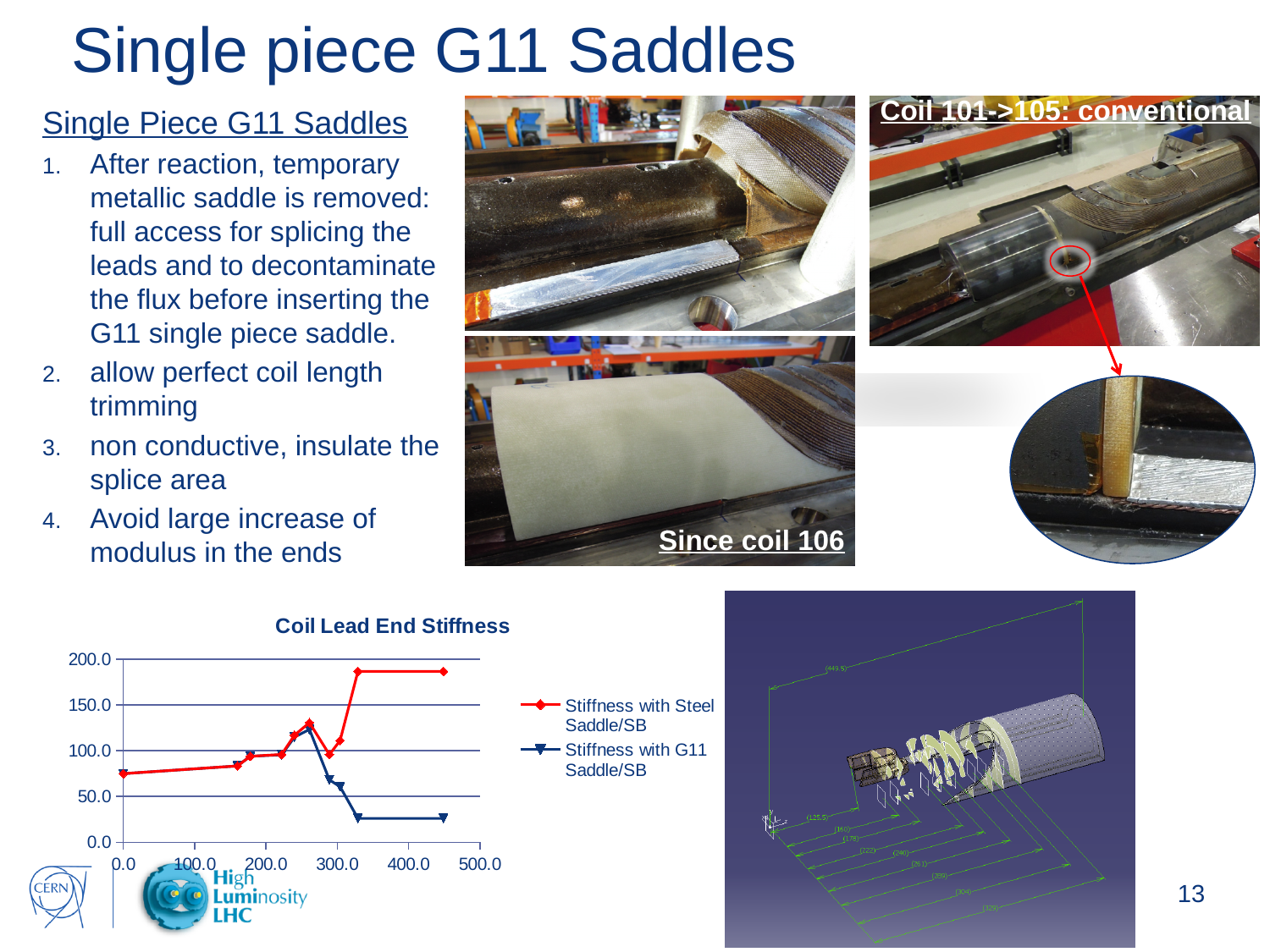
In the 'Coil Lead End Stiffness' chart, does the 'Stiffness with G11 Saddle/SB' series rise or fall between x = 260 and x = 330? fall What kind of chart is the 'Coil Lead End Stiffness' chart? line chart In the 'Coil Lead End Stiffness' chart, which series has the lower value at x = 330, 'Stiffness with Steel Saddle/SB' or 'Stiffness with G11 Saddle/SB'? Stiffness with G11 Saddle/SB In the 'Coil Lead End Stiffness' chart, does the 'Stiffness with Steel Saddle/SB' series rise or fall between x = 260 and x = 330? rise In the 'Coil Lead End Stiffness' chart, is the value of 'Stiffness with Steel Saddle/SB' at x = 450 greater or less than 150? greater In the 'Coil Lead End Stiffness' chart, is the value of 'Stiffness with G11 Saddle/SB' at x = 450 greater or less than 50? less What is the title of the chart at the bottom left of the slide? Coil Lead End Stiffness How many series does the legend of the 'Coil Lead End Stiffness' chart list? 2 In the 'Coil Lead End Stiffness' chart, is the value of 'Stiffness with Steel Saddle/SB' at x = 0 greater or less than 100? less In the 'Coil Lead End Stiffness' chart, which series is drawn in red? Stiffness with Steel Saddle/SB In the 'Coil Lead End Stiffness' chart, which series has the higher value at x = 450, 'Stiffness with Steel Saddle/SB' or 'Stiffness with G11 Saddle/SB'? Stiffness with Steel Saddle/SB